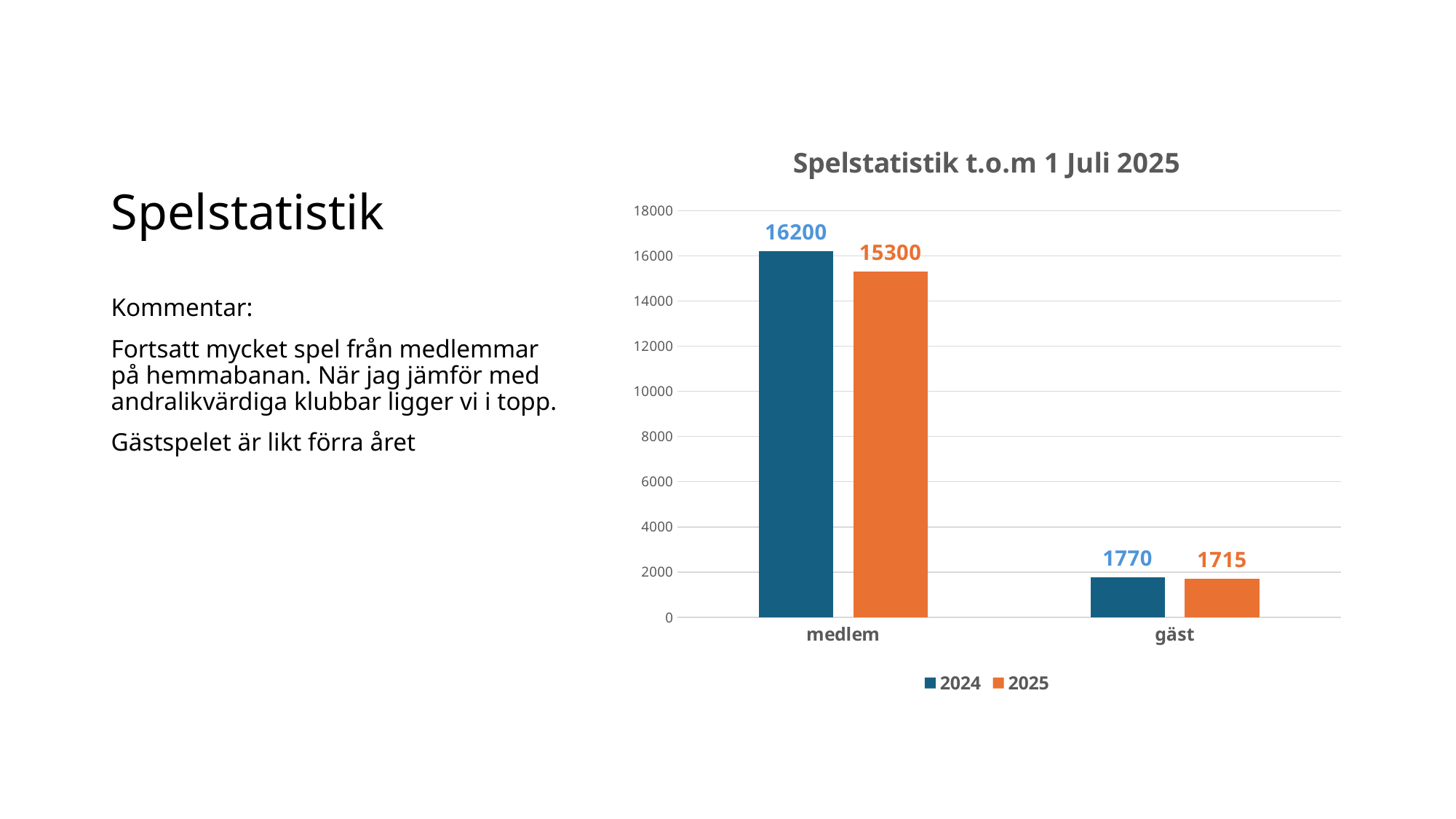
What is the difference between the 2024 and 2025 values for medlem? 900 What is the value for gäst in the 2025 series? 1715 What is the value for gäst in the 2024 series? 1770 What is the title of the chart? Spelstatistik t.o.m 1 Juli 2025 What is the value for medlem in the 2024 series? 16200 Which category has the highest value in the 2024 series? medlem Which category has the lowest value in the 2025 series? gäst How many categories are shown on the x axis? 2 What is the difference between the 2024 and 2025 values for gäst? 55 What is the value for medlem in the 2025 series? 15300 Which is larger for medlem, the 2024 value or the 2025 value? 2024 How many series does the legend list? 2